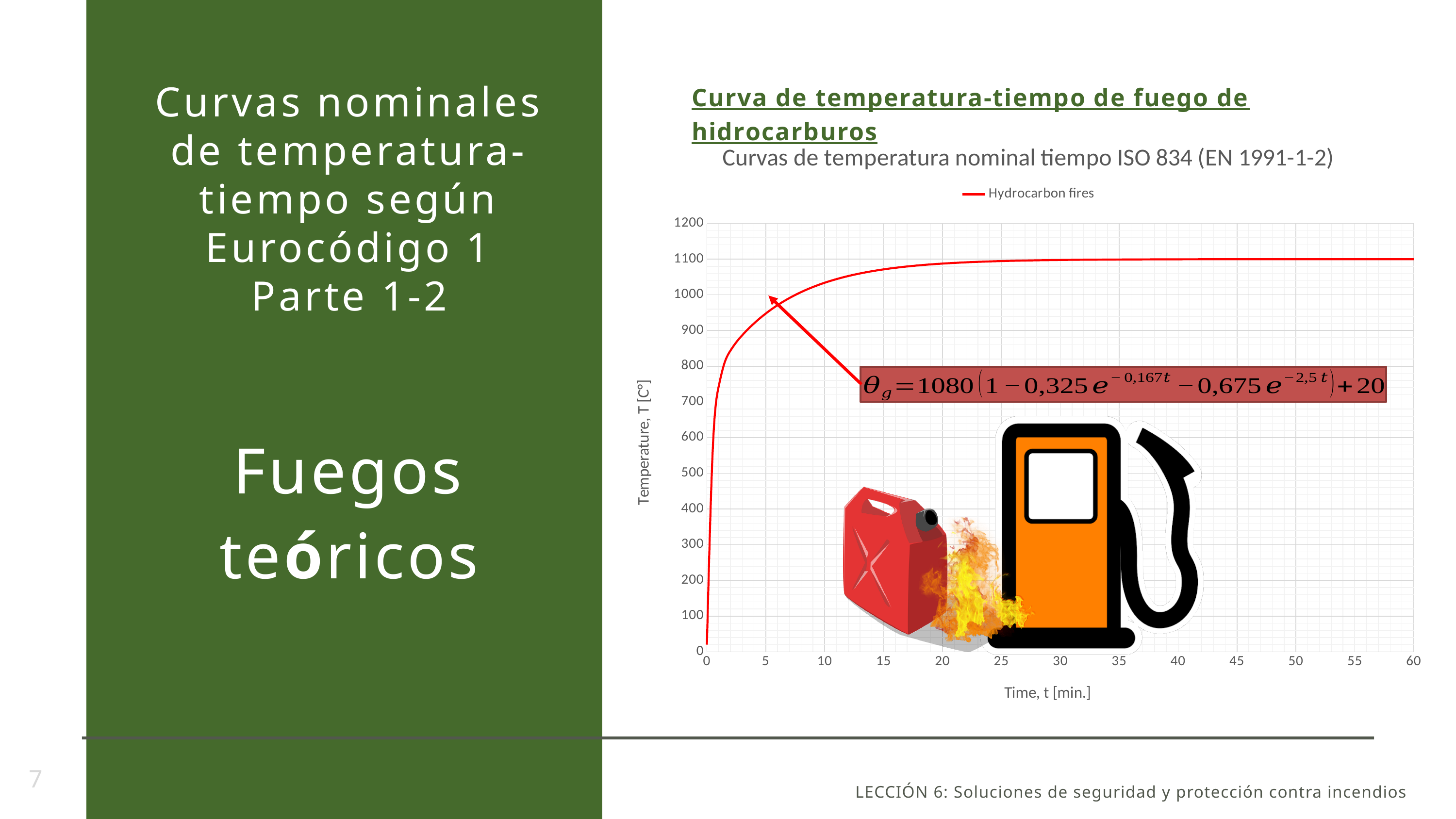
What kind of chart is shown on the slide? line chart Is the Hydrocarbon fires temperature at 10 minutes greater or less than 1000? greater What is the maximum time value shown on the x axis of the chart? 60 What is the name of the series shown in the chart legend? Hydrocarbon fires Is the Hydrocarbon fires temperature at 30 minutes greater or less than 1000? greater Is the Hydrocarbon fires temperature at 5 minutes greater or less than 800? greater What is the title of the chart? Curvas de temperatura nominal tiempo ISO 834 (EN 1991-1-2) Does the Hydrocarbon fires temperature rise or fall as time increases along the x axis? rise How many series does the chart legend list? 1